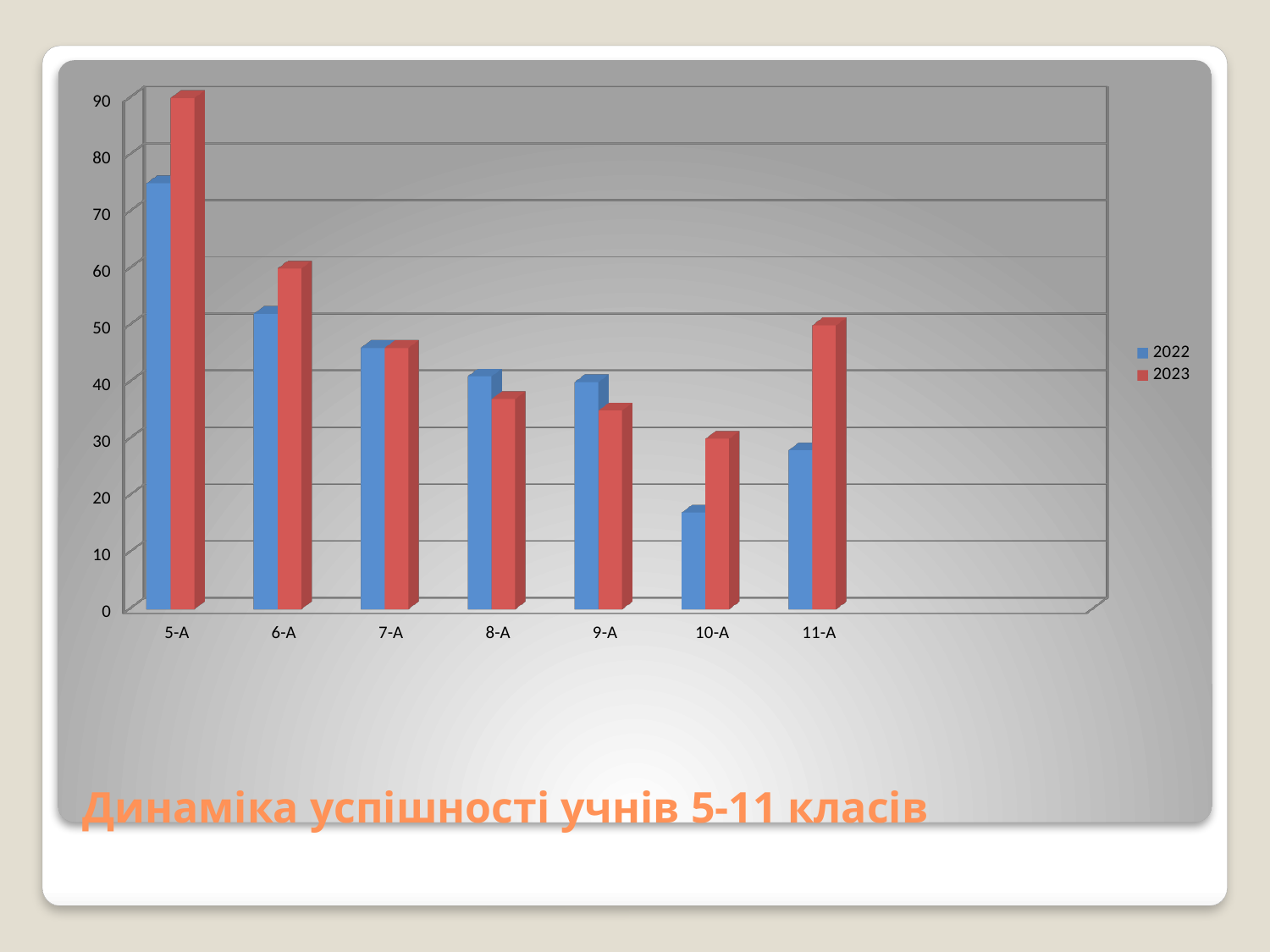
What is the title of the chart? Динаміка успішності учнів 5-11 класів Which colour represents the 2023 series? red For 8-A, which series has the larger value, 2022 or 2023? 2022 How many classes (categories) are shown on the x axis? 7 What kind of chart is shown on the slide? bar chart Which class has the highest value for 2023? 5-A Which class has the lowest value for 2023? 10-A Which class has the lowest value for 2022? 10-A Is the 2022 value for 10-A greater or less than 20? less Is the 2022 value for 5-A greater or less than 70? greater For 11-A, which series has the larger value, 2022 or 2023? 2023 How many series does the legend list? 2